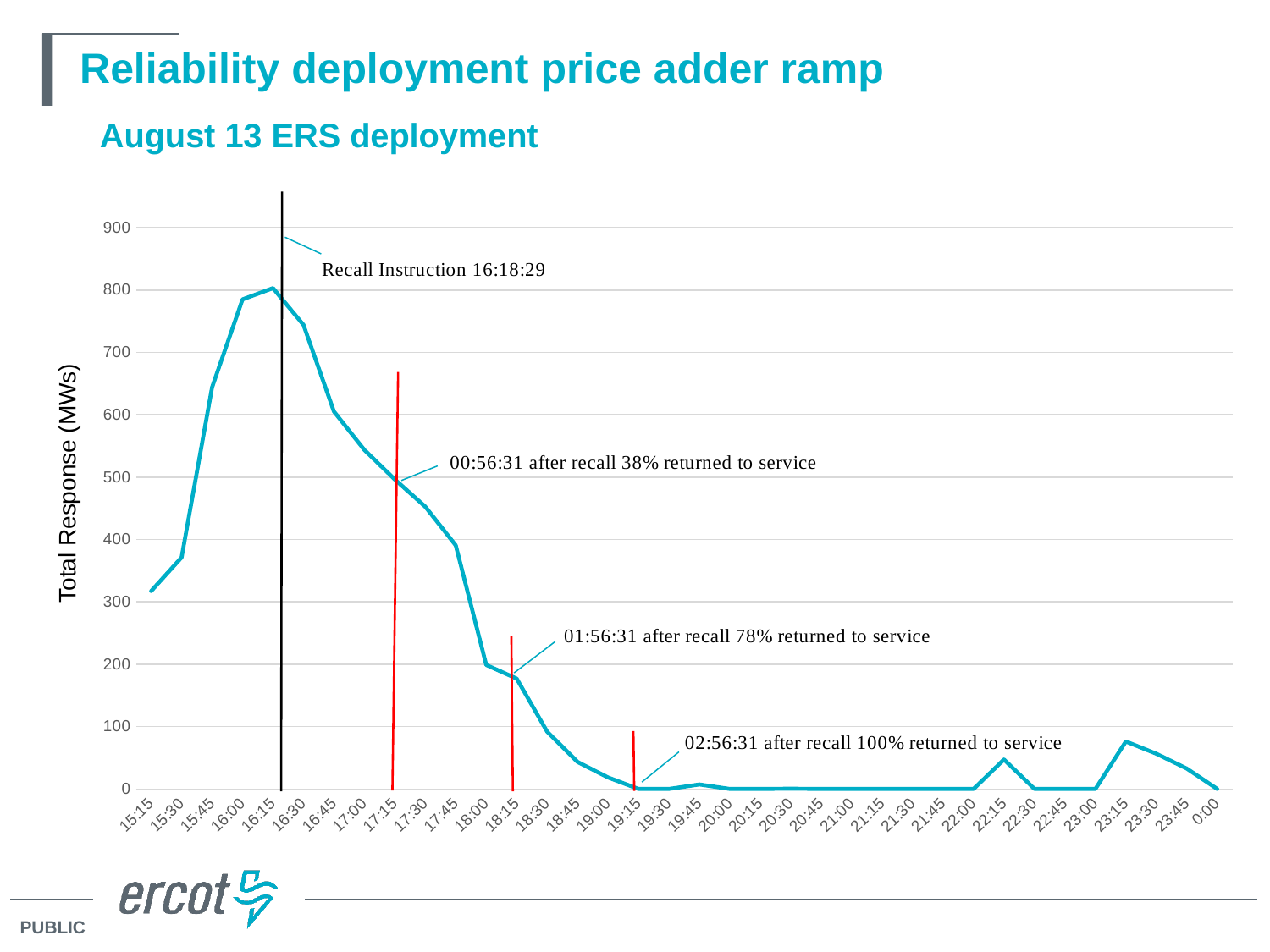
Is the Total Response value at 15:15 greater or less than 400? less Which is larger, the Total Response at 16:15 or at 16:30? 16:15 What kind of chart is shown on the slide? line chart What is the label of the vertical axis? Total Response (MWs) Is the Total Response value at 16:00 greater or less than 700? greater Does the Total Response rise or fall between 15:15 and 16:15? rise At which time does the Total Response line reach its highest value? 16:15 Is the Total Response value at 17:00 greater or less than 500? greater What time is given for the Recall Instruction on the chart? 16:18:29 Does the Total Response rise or fall between 16:15 and 19:15? fall